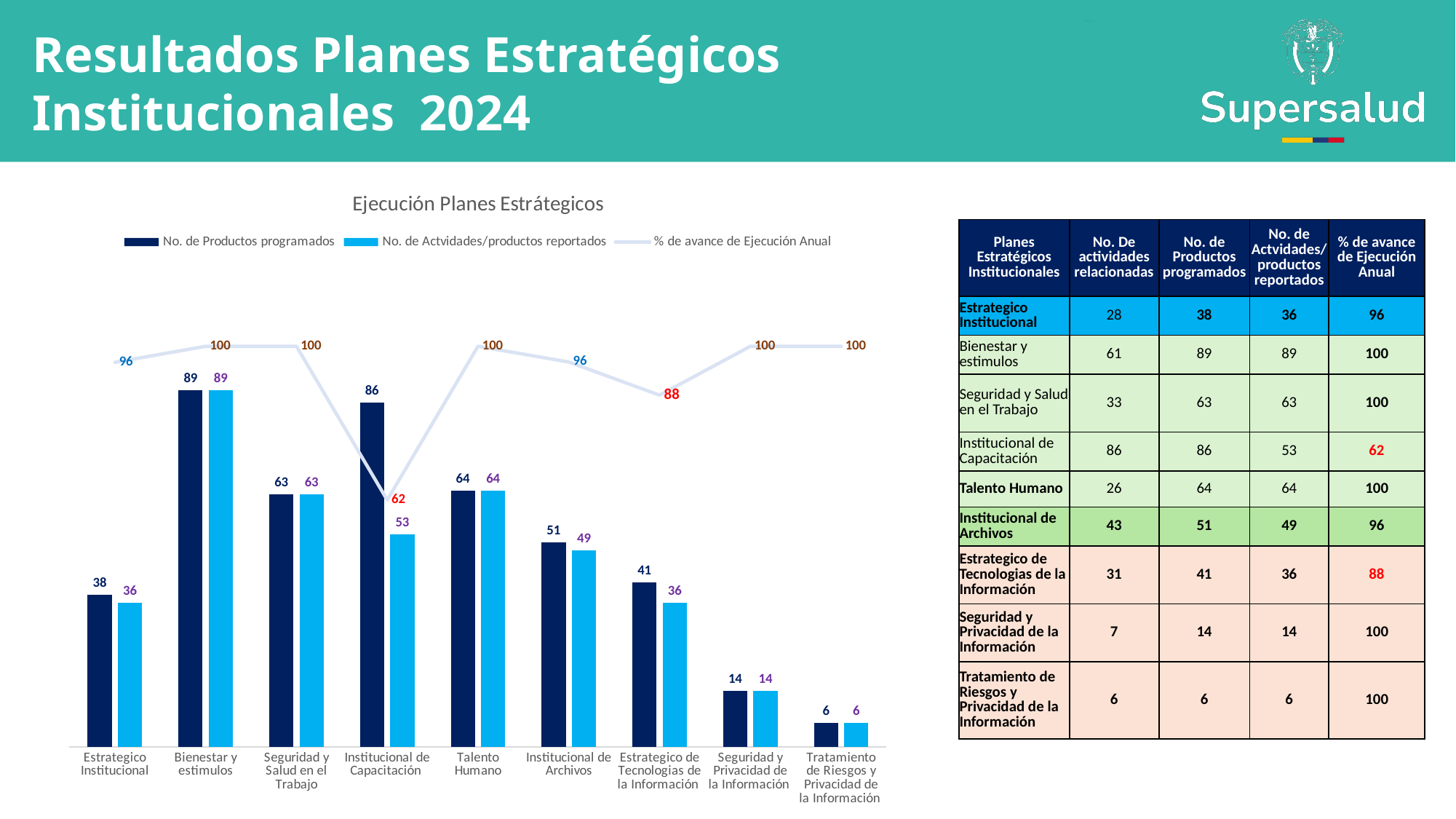
What is the value of No. de Actvidades/productos reportados for Institucional de Archivos? 49 What is the title of the chart? Ejecución Planes Estrátegicos What is the value of No. de Productos programados for Institucional de Capacitación? 86 Which is larger for Estrategico Institucional: No. de Productos programados or No. de Actvidades/productos reportados? No. de Productos programados What kind of chart is shown on the slide? Bar and line chart Which category has the highest value for No. de Productos programados? Bienestar y estimulos What is the value of No. de Productos programados for Tratamiento de Riesgos y Privacidad de la Información? 6 How many series does the chart legend list? 3 How many categories are shown on the x axis of the chart? 9 Which category has the lowest % de avance de Ejecución Anual? Institucional de Capacitación What is the % de avance de Ejecución Anual for Estrategico de Tecnologias de la Información? 88 What is the difference between No. de Productos programados and No. de Actvidades/productos reportados for Institucional de Capacitación? 33